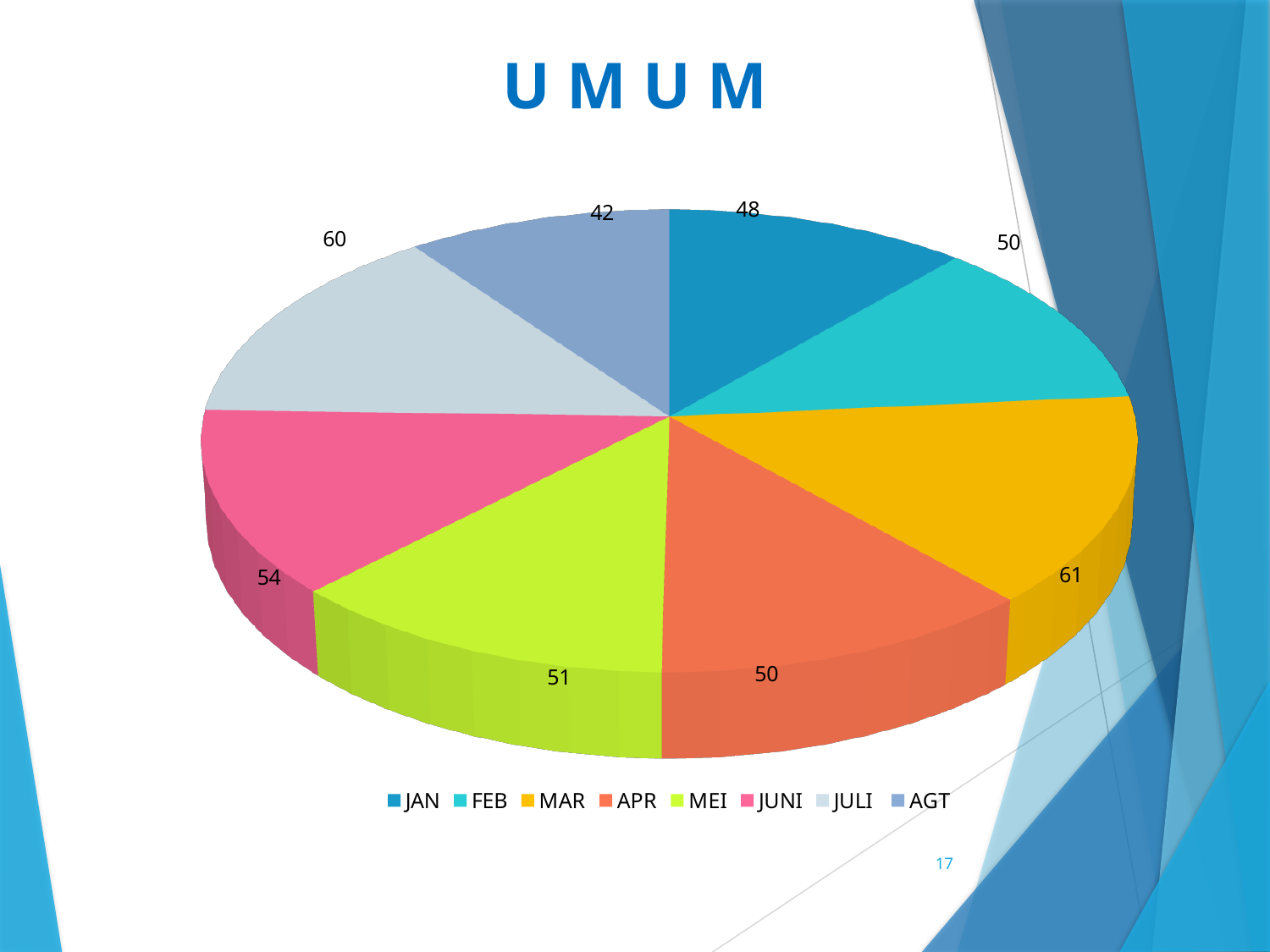
Which month has the smallest slice? AGT Which month has the largest slice? MAR How many slices does the pie chart have? 8 What is the value for AGT? 42 Which is larger, the value for JUNI or the value for MEI? JUNI What type of chart is shown on the slide? Pie chart Which legend entry is shown in pink? JUNI What is the value for JAN? 48 What is the value for MAR? 61 What is the difference between the values for MAR and AGT? 19 What is the title of the chart? UMUM What is the value for JULI? 60